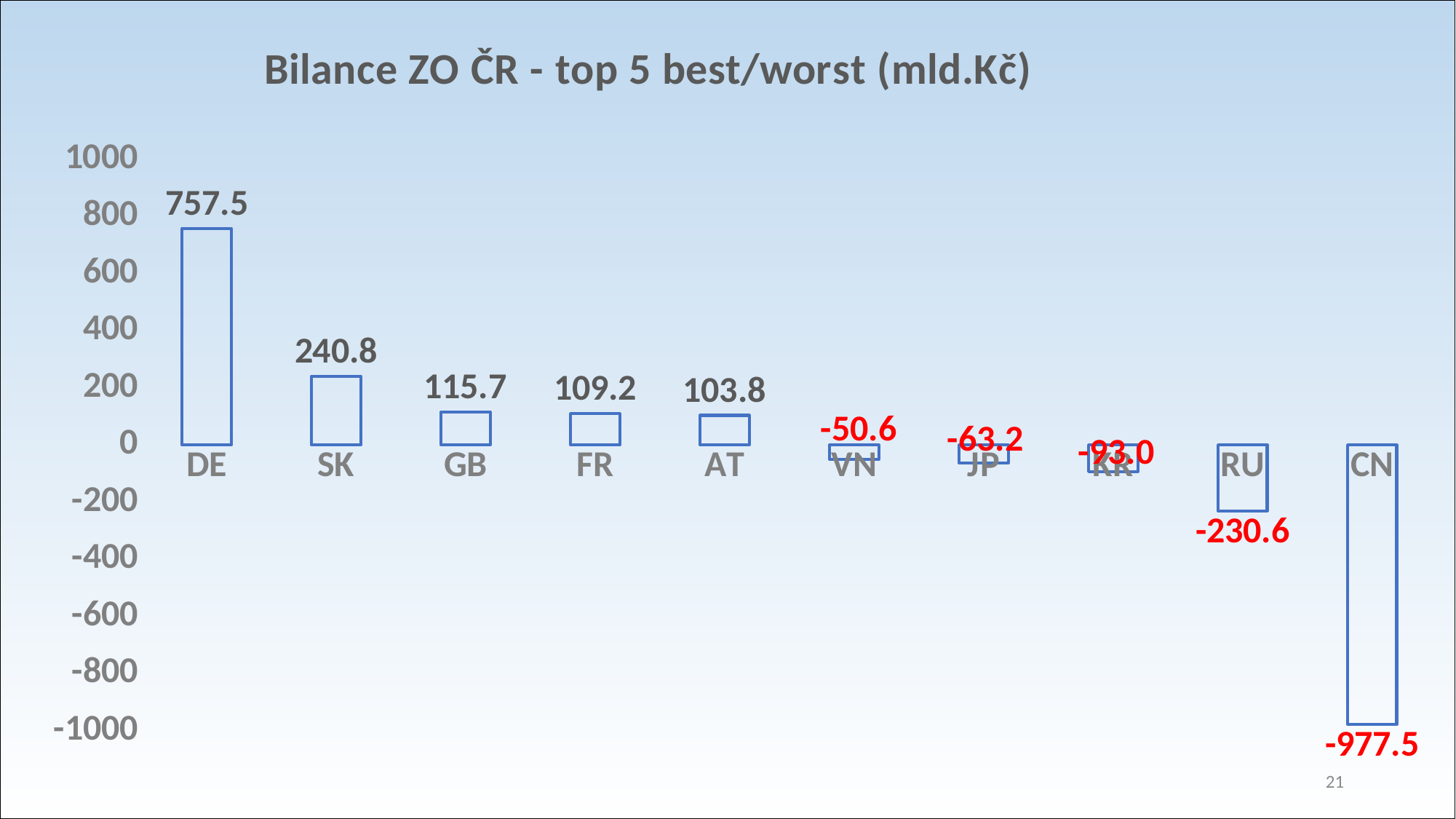
How many categories are shown on the x axis? 10 What is the difference between the values for DE and SK? 516.7 What kind of chart is shown on the slide? Bar chart What is the value for CN? -977.5 What is the value for RU? -230.6 Which category has the lowest value? CN What is the title of the chart? Bilance ZO ČR - top 5 best/worst (mld.Kč) What is the value for AT? 103.8 Do the values rise or fall from left to right along the x axis? Fall Which is larger, the value for GB or the value for FR? GB What is the value for DE? 757.5 Which category has the highest value? DE